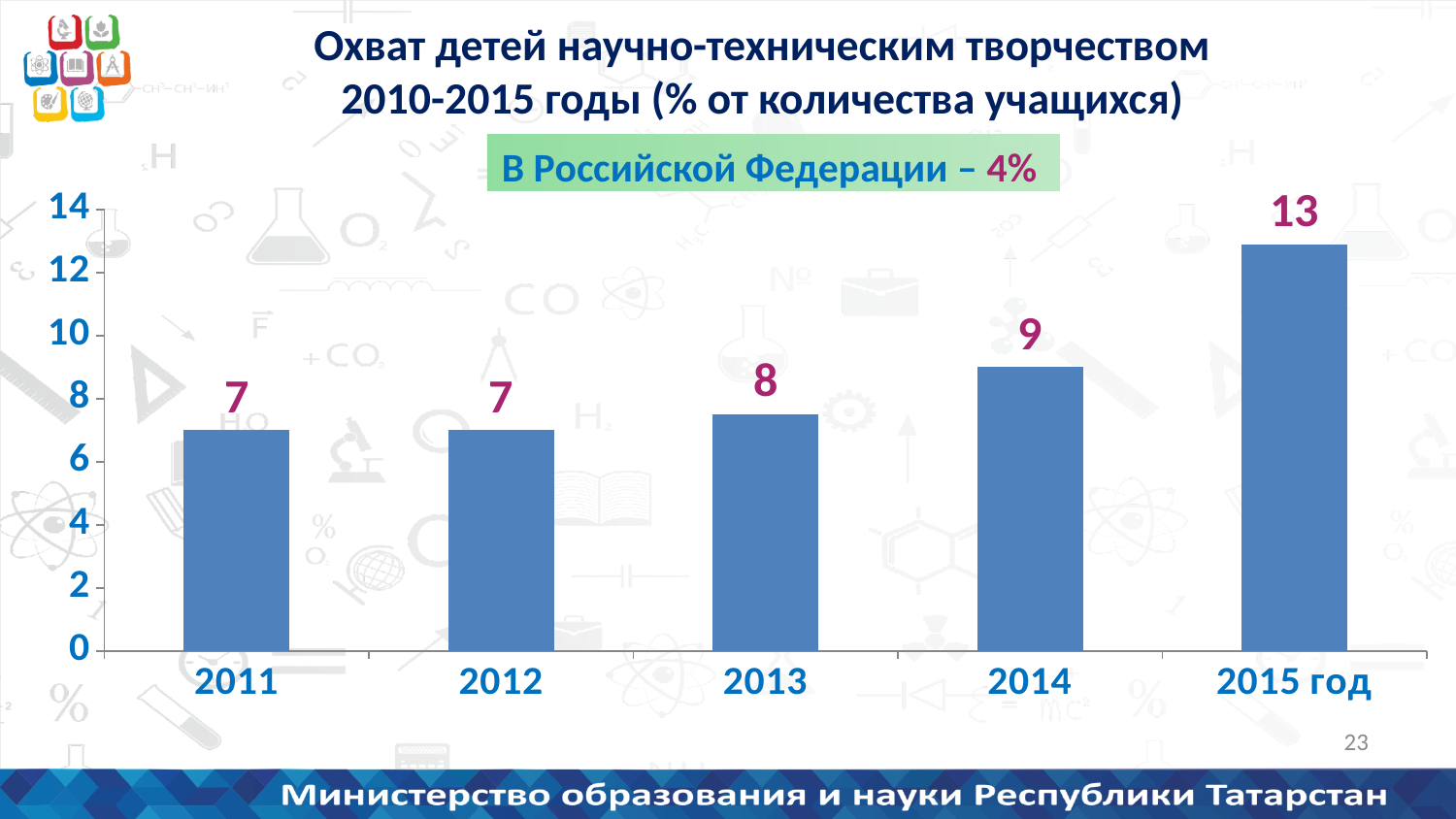
Which year has the highest value? 2015 год Which is larger, the value for 2014 or the value for 2012? 2014 What kind of chart is shown on the slide? bar chart What is the difference between the values for 2015 год and 2014? 4 What is the value for 2011? 7 What is the difference between the values for 2013 and 2011? 1 What is the value for 2013? 8 What is the value for 2015 год? 13 Do the values rise or fall from 2011 to 2015 год? rise Is the value for 2015 год greater or less than 12? greater How many years are shown on the x axis? 5 What is the value for 2014? 9